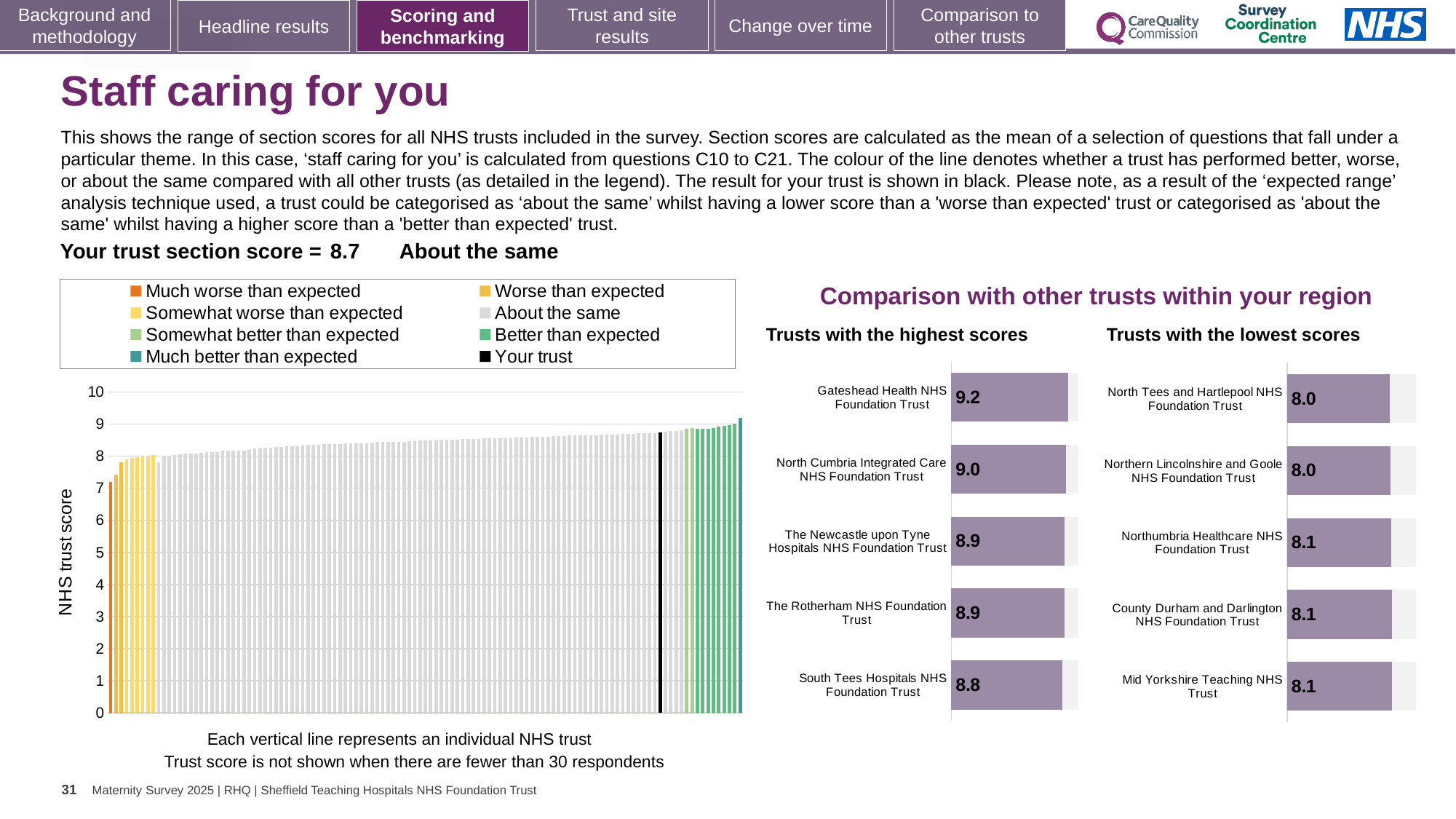
In the main chart on the left, is the value for your trust (the black bar) greater or less than 8? greater In the 'Trusts with the highest scores' chart, what is the difference between the scores of Gateshead Health NHS Foundation Trust and South Tees Hospitals NHS Foundation Trust? 0.4 In the 'Trusts with the lowest scores' chart, what is the difference between the scores of Northumbria Healthcare NHS Foundation Trust and North Tees and Hartlepool NHS Foundation Trust? 0.1 In the 'Trusts with the lowest scores' chart, what is the score for Mid Yorkshire Teaching NHS Trust? 8.1 In the 'Trusts with the highest scores' chart, which trust has the highest score? Gateshead Health NHS Foundation Trust In the 'Trusts with the highest scores' chart, what is the score for South Tees Hospitals NHS Foundation Trust? 8.8 In the 'Trusts with the highest scores' chart, which has the larger score: North Cumbria Integrated Care NHS Foundation Trust or The Newcastle upon Tyne Hospitals NHS Foundation Trust? North Cumbria Integrated Care NHS Foundation Trust In the 'Trusts with the highest scores' chart, what is the score for Gateshead Health NHS Foundation Trust? 9.2 How many trusts are shown in the 'Trusts with the highest scores' chart? 5 What is the y-axis title of the main chart on the left? NHS trust score How many entries does the legend of the main chart on the left list? 8 What kind of chart is the main chart on the left showing all NHS trusts? Bar chart